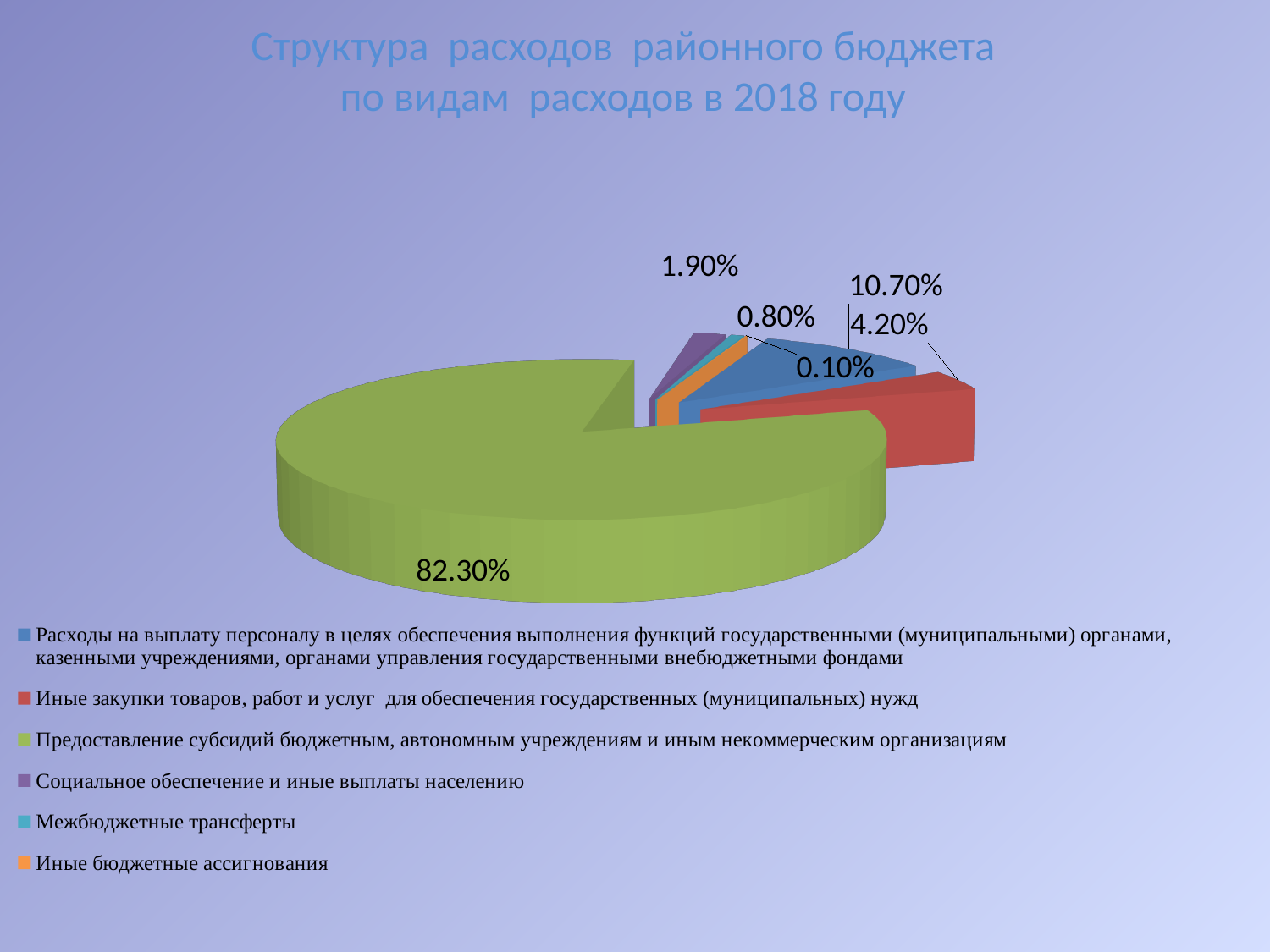
What is the smallest value shown on the pie chart? 0.10% What kind of chart is shown on the slide? pie chart What is the largest value shown on the pie chart? 82.30% What colour is the slice for Предоставление субсидий бюджетным, автономным учреждениям и иным некоммерческим организациям? green Which is larger: the slice for Предоставление субсидий бюджетным, автономным учреждениям и иным некоммерческим организациям or the slice for Социальное обеспечение и иные выплаты населению? Предоставление субсидий бюджетным, автономным учреждениям и иным некоммерческим организациям What share of the pie is labelled for Предоставление субсидий бюджетным, автономным учреждениям и иным некоммерческим организациям? 82.30% How many entries does the legend list? 6 What is the difference between the largest and smallest values shown on the pie chart? 82.20% What is the title of the chart? Структура расходов районного бюджета по видам расходов в 2018 году What value is labelled for the Социальное обеспечение и иные выплаты населению slice? 1.90% How many slices does the pie chart have? 6 Which expenditure type has the largest share of the pie? Предоставление субсидий бюджетным, автономным учреждениям и иным некоммерческим организациям